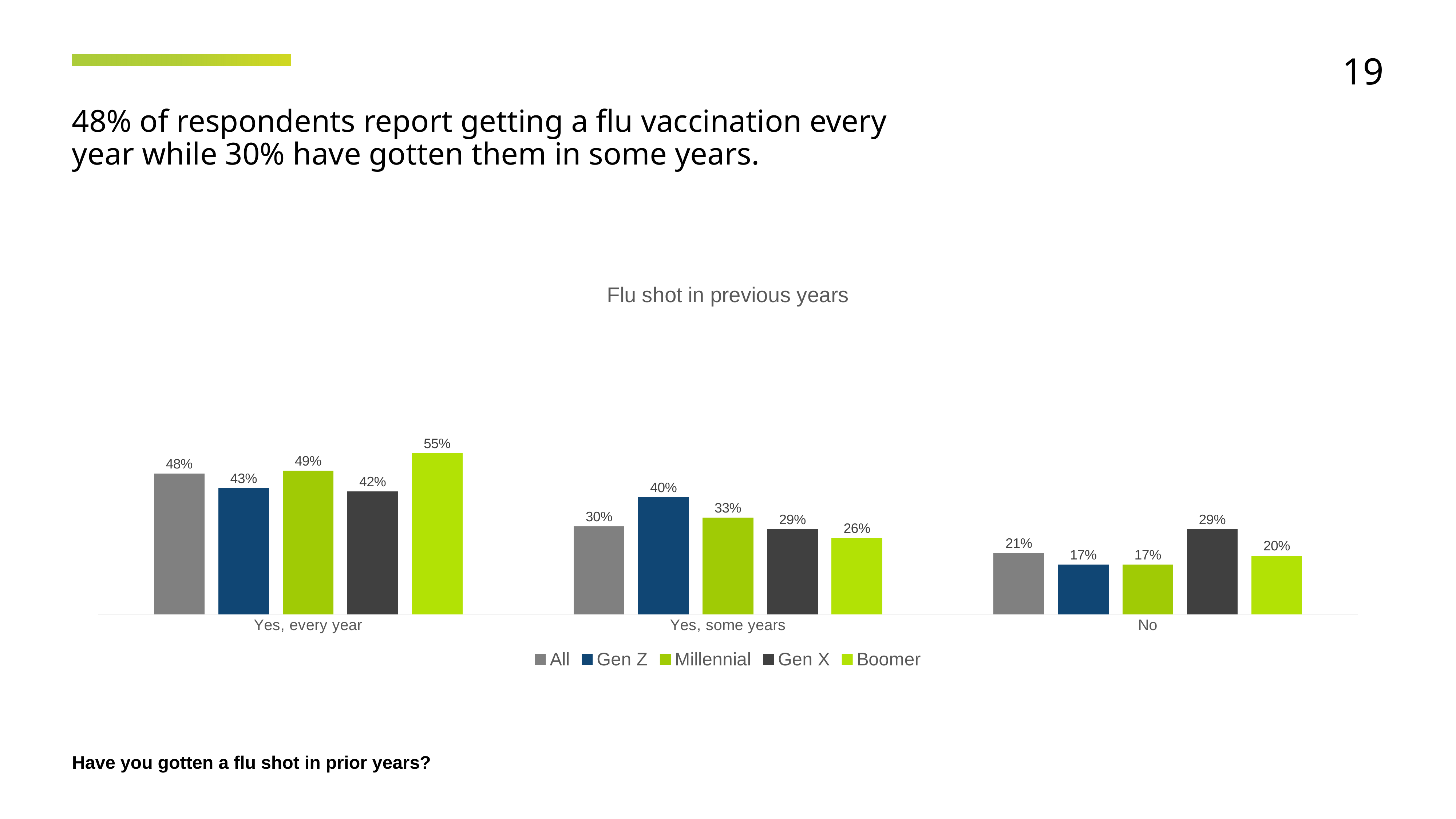
How many categories are shown on the x axis? 3 What is the value for Gen X in the "No" category? 29% What is the difference between the Boomer and Gen X values in the "Yes, every year" category? 13% What is the value for Boomer in the "Yes, every year" category? 55% How many series does the legend list? 5 What kind of chart is shown on the slide? Bar chart Which series has the highest value in the "Yes, every year" category? Boomer What is the value for Gen Z in the "Yes, some years" category? 40% What is the title of the chart? Flu shot in previous years Which series has the lowest value in the "Yes, some years" category? Boomer In the "No" category, which is larger: the value for All or the value for Gen X? Gen X What is the difference between the Gen Z and Millennial values in the "Yes, some years" category? 7%